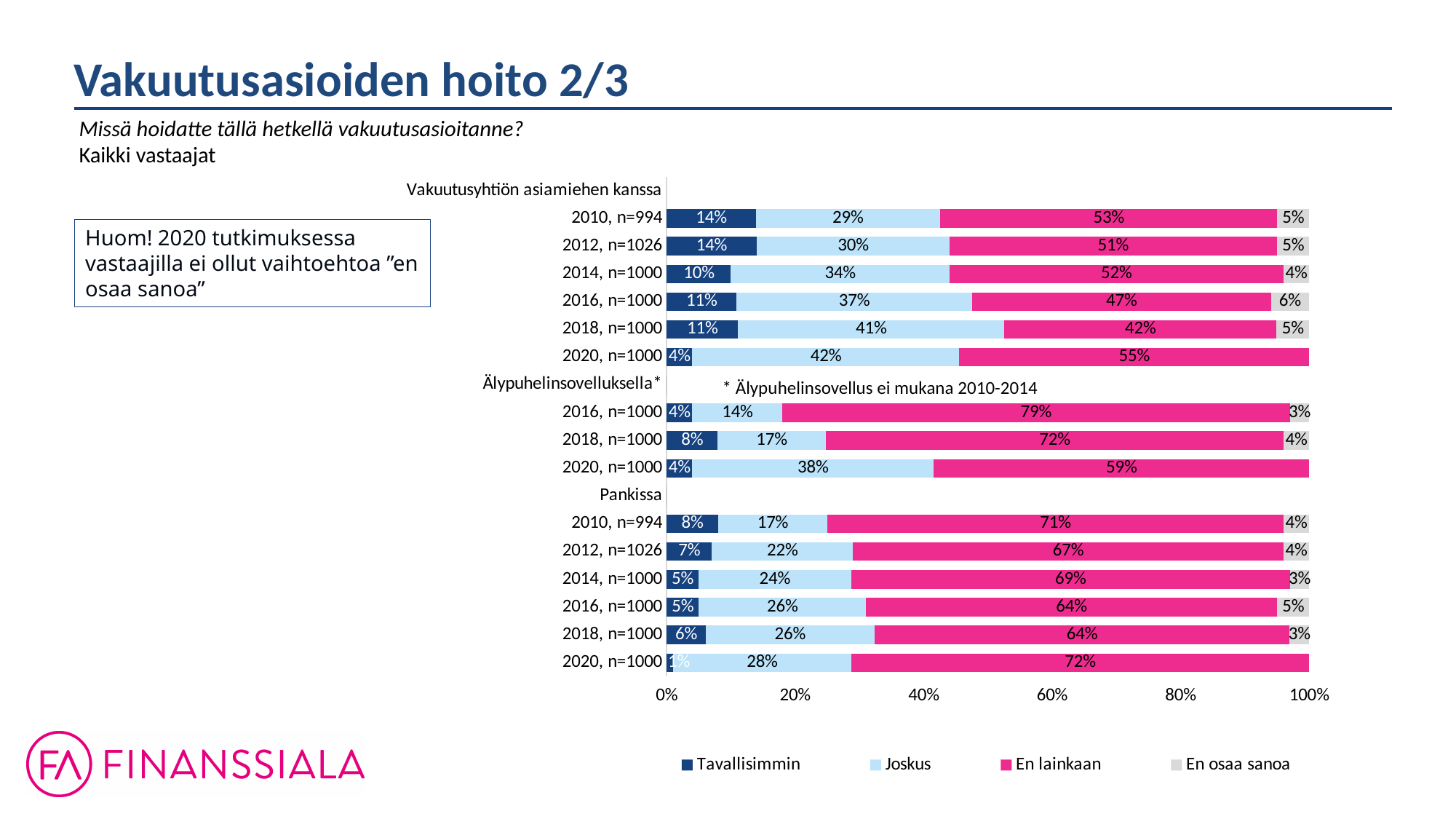
How many series does the legend list? 4 What is the difference between the "Joskus" values for "Vakuutusyhtiön asiamiehen kanssa" in 2020, n=1000 and 2010, n=994? 13% Which is larger: the "En lainkaan" value for "Pankissa" in 2010, n=994 or for "Vakuutusyhtiön asiamiehen kanssa" in 2010, n=994? Pankissa 2010, n=994 How many bars are plotted in the chart in total? 15 What is the "Joskus" value for "Pankissa" in 2020, n=1000? 28% How does the "Joskus" value for "Vakuutusyhtiön asiamiehen kanssa" change from 2010 to 2020? It rises Within the "Pankissa" group, which year has the lowest "Tavallisimmin" value? 2020, n=1000 What is the "En lainkaan" value for "Älypuhelinsovelluksella" in 2016, n=1000? 79% Within the "Älypuhelinsovelluksella" group, which year has the highest "En lainkaan" value? 2016, n=1000 What percentage of respondents answered "Tavallisimmin" for "Vakuutusyhtiön asiamiehen kanssa" in 2010, n=994? 14% What is the "En osaa sanoa" value for "Vakuutusyhtiön asiamiehen kanssa" in 2016, n=1000? 6% What kind of chart is shown on the slide? Stacked bar chart